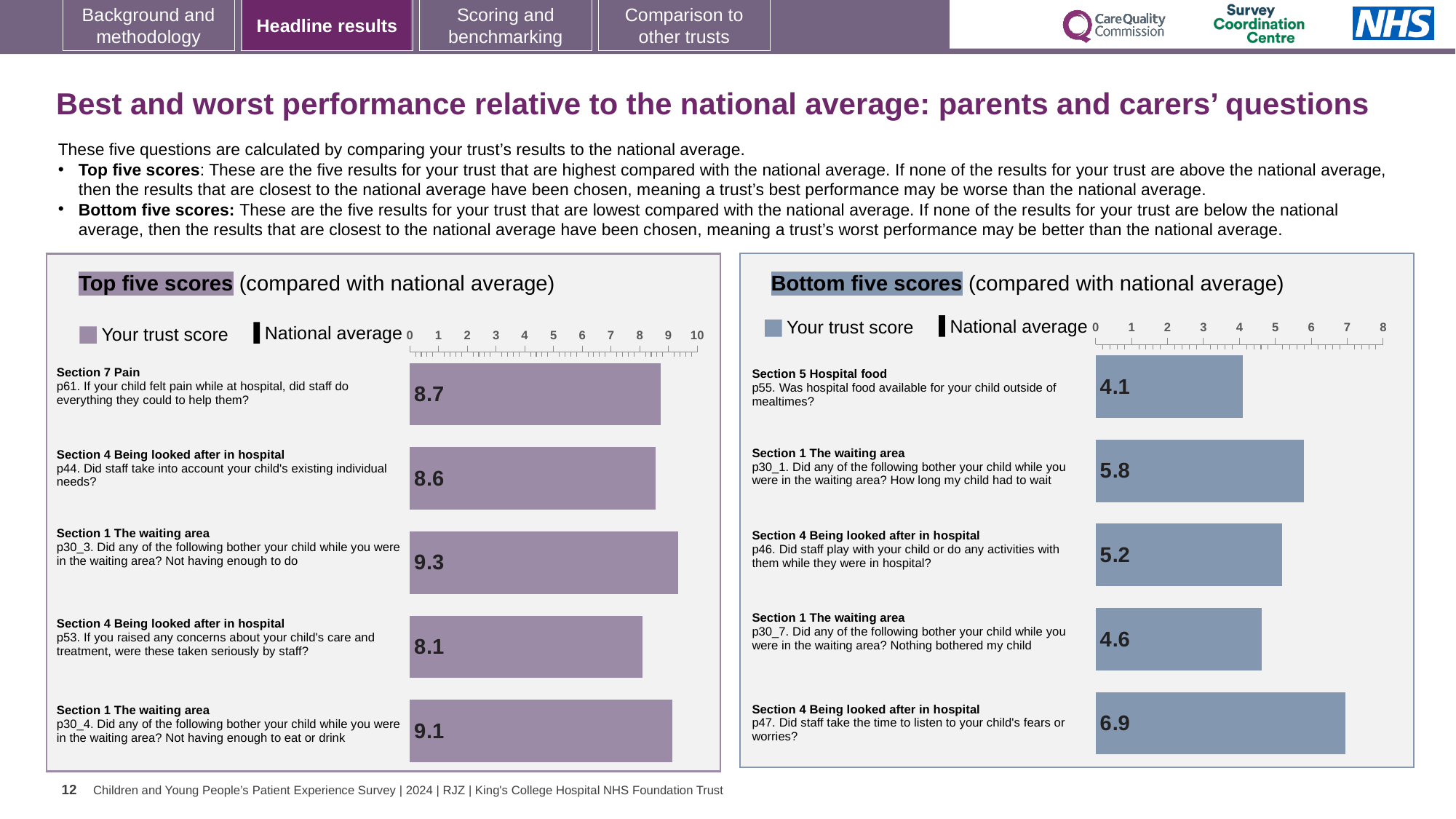
In the Top five scores chart, what is the difference between the trust scores for p30_3 and p53? 1.2 In the Bottom five scores chart, what is the difference between the trust scores for p47 and p55? 2.8 In the Top five scores chart, which question has the highest trust score? p30_3. Did any of the following bother your child while you were in the waiting area? Not having enough to do What kind of chart is the Top five scores chart? Bar chart In the Bottom five scores chart, which question has the lowest trust score? p55. Was hospital food available for your child outside of mealtimes? In the Top five scores chart, which question has the lowest trust score? p53. If you raised any concerns about your child's care and treatment, were these taken seriously by staff? How many questions are plotted in the Bottom five scores chart? 5 In the Top five scores chart, what is the trust score for p61 (If your child felt pain while at hospital, did staff do everything they could to help them)? 8.7 In the Bottom five scores chart, which is larger: the trust score for p30_1 (How long my child had to wait) or for p46 (Did staff play with your child or do any activities)? p30_1 (How long my child had to wait) In the Top five scores chart, what is the trust score for p30_3 (Not having enough to do in the waiting area)? 9.3 In the Bottom five scores chart, what is the trust score for p55 (Was hospital food available for your child outside of mealtimes)? 4.1 In the Bottom five scores chart, what is the trust score for p47 (Did staff take the time to listen to your child's fears or worries)? 6.9